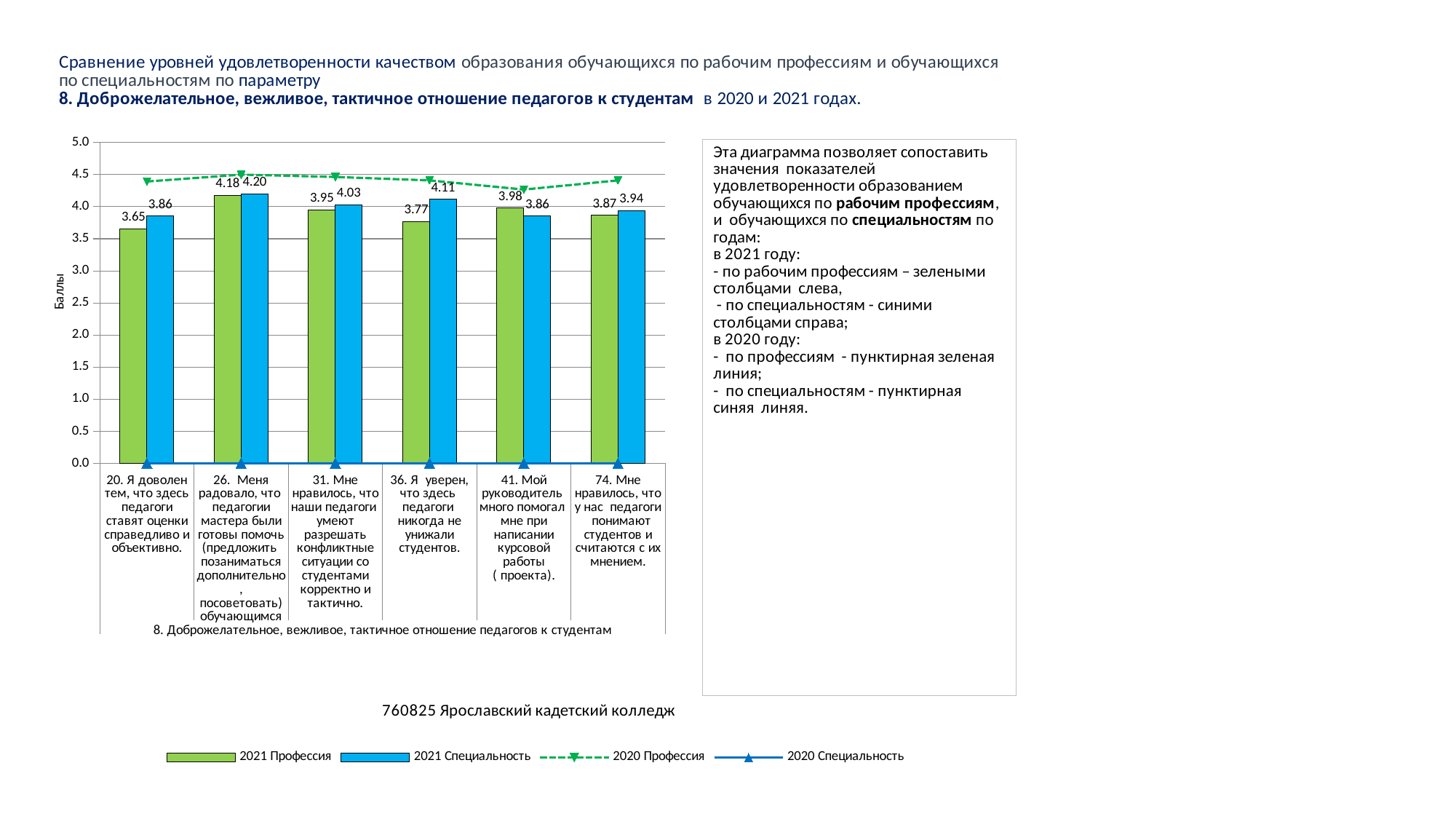
What is the difference between the 2021 Специальность and 2021 Профессия values for category 36? 0.34 For category 41 (Мой руководитель много помогал мне при написании курсовой работы), which is larger: the 2021 Профессия bar or the 2021 Специальность bar? 2021 Профессия Which category has the lowest 2021 Профессия bar? 20. Я доволен тем, что здесь педагоги ставят оценки справедливо и объективно Which category has the highest 2021 Профессия bar? 26. Меня радовало, что педагоги и мастера были готовы помочь How many categories are shown on the x axis of the chart? 6 How many series does the chart legend list? 4 What is the value of the 2021 Специальность bar for category 26 (Меня радовало, что педагоги и мастера были готовы помочь)? 4.20 Is the 2020 Профессия dashed line value for category 20 greater or less than 4.0? greater What type of chart is shown on the slide? Combined bar and line chart What is the label of the vertical axis of the chart? Баллы What is the value of the 2021 Профессия bar for category 20 (Я доволен тем, что здесь педагоги ставят оценки справедливо и объективно)? 3.65 What is the value of the 2021 Специальность bar for category 36 (Я уверен, что здесь педагоги никогда не унижали студентов)? 4.11